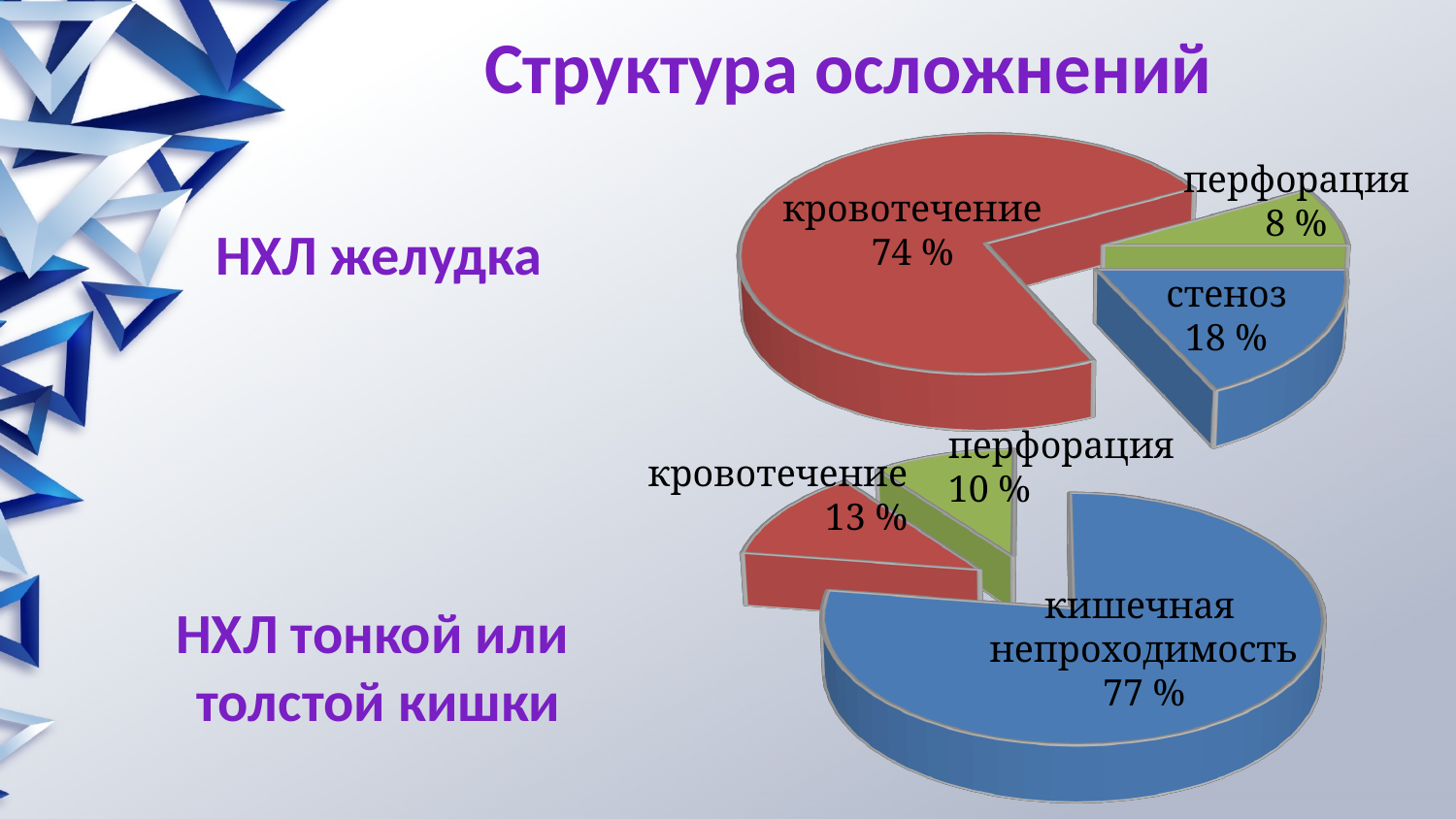
In the bottom pie chart (НХЛ тонкой или толстой кишки), what is the share for кровотечение? 13 % In the top pie chart (НХЛ желудка), what is the share for стеноз? 18 % In the top pie chart (НХЛ желудка), what is the share for перфорация? 8 % In the bottom pie chart (НХЛ тонкой или толстой кишки), what is the share for кишечная непроходимость? 77 % In the bottom pie chart (НХЛ тонкой или толстой кишки), which complication has the smallest share? перфорация In the top pie chart (НХЛ желудка), what is the difference between the shares for стеноз and перфорация? 10 % In the top pie chart (НХЛ желудка), which complication has the largest share? кровотечение In the top pie chart (НХЛ желудка), what is the share for кровотечение? 74 % In the bottom pie chart (НХЛ тонкой или толстой кишки), which is larger: кровотечение or перфорация? кровотечение In the bottom pie chart (НХЛ тонкой или толстой кишки), what is the share for перфорация? 10 % How many slices does the top pie chart (НХЛ желудка) have? 3 What type of chart is used for НХЛ тонкой или толстой кишки? pie chart